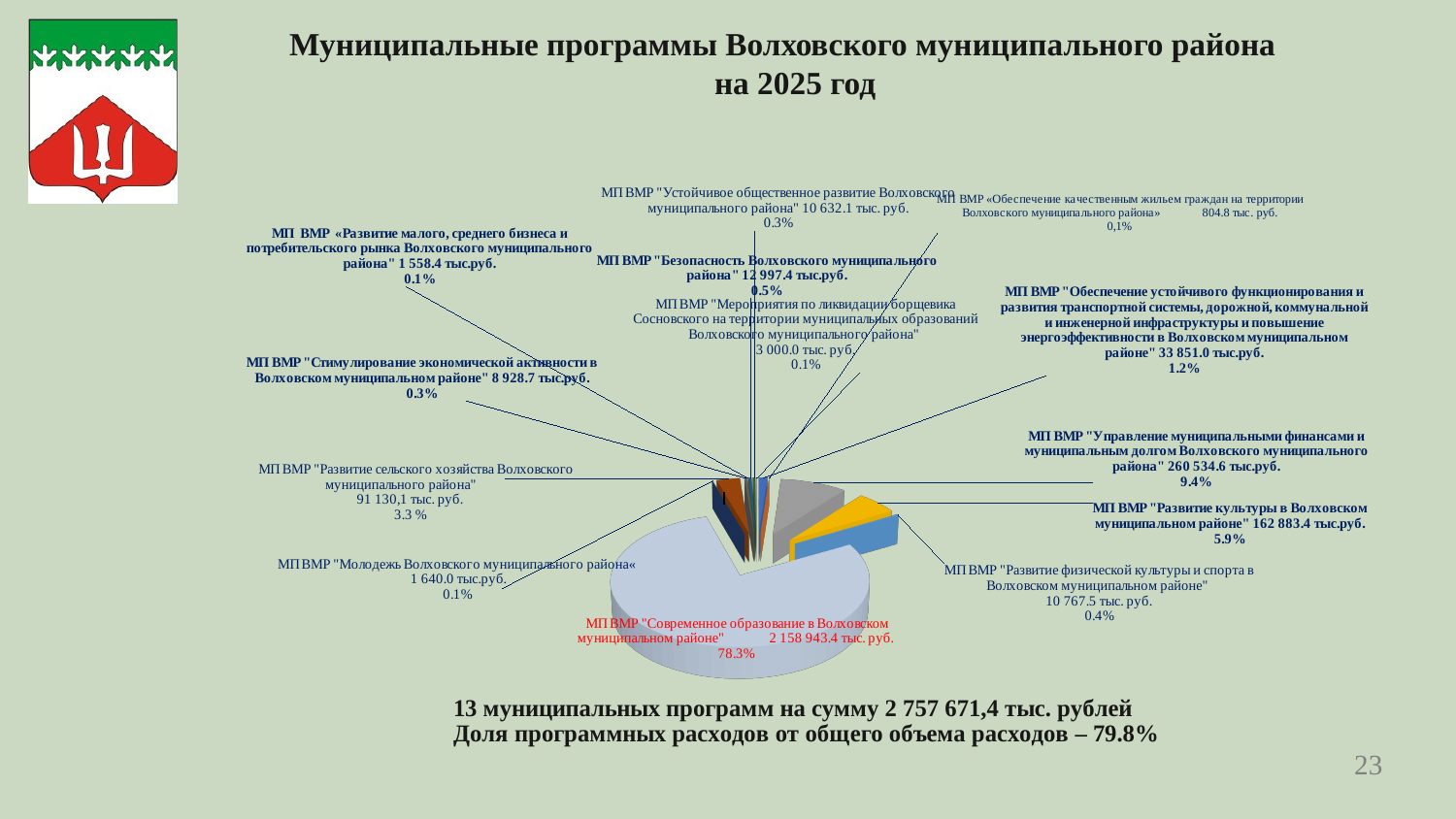
What is the title of the slide containing the pie chart? Муниципальные программы Волховского муниципального района на 2025 год What kind of chart is shown on the slide? Pie chart What is the amount for the program "Управление муниципальными финансами и муниципальным долгом Волховского муниципального района"? 260 534.6 тыс.руб. How many municipal programs (slices) does the pie chart show? 13 Which program has the largest share of the pie? МП ВМР "Современное образование в Волховском муниципальном районе" What share of the pie does the program "Развитие сельского хозяйства Волховского муниципального района" have? 3.3 % What is the amount for the program "Развитие культуры в Волховском муниципальном районе"? 162 883.4 тыс.руб. Which program has the smallest amount in the pie chart? МП ВМР «Обеспечение качественным жильем граждан на территории Волховского муниципального района» What is the amount for the program "Безопасность Волховского муниципального района"? 12 997.4 тыс.руб. What is the difference between the amounts for "Управление муниципальными финансами и муниципальным долгом" (260 534.6 тыс.руб.) and "Развитие культуры в Волховском муниципальном районе" (162 883.4 тыс.руб.)? 97 651.2 тыс.руб. Which is larger: the amount for "Управление муниципальными финансами и муниципальным долгом" or for "Развитие культуры в Волховском муниципальном районе"? Управление муниципальными финансами и муниципальным долгом What share of the pie does the program "Современное образование в Волховском муниципальном районе" have? 78.3%